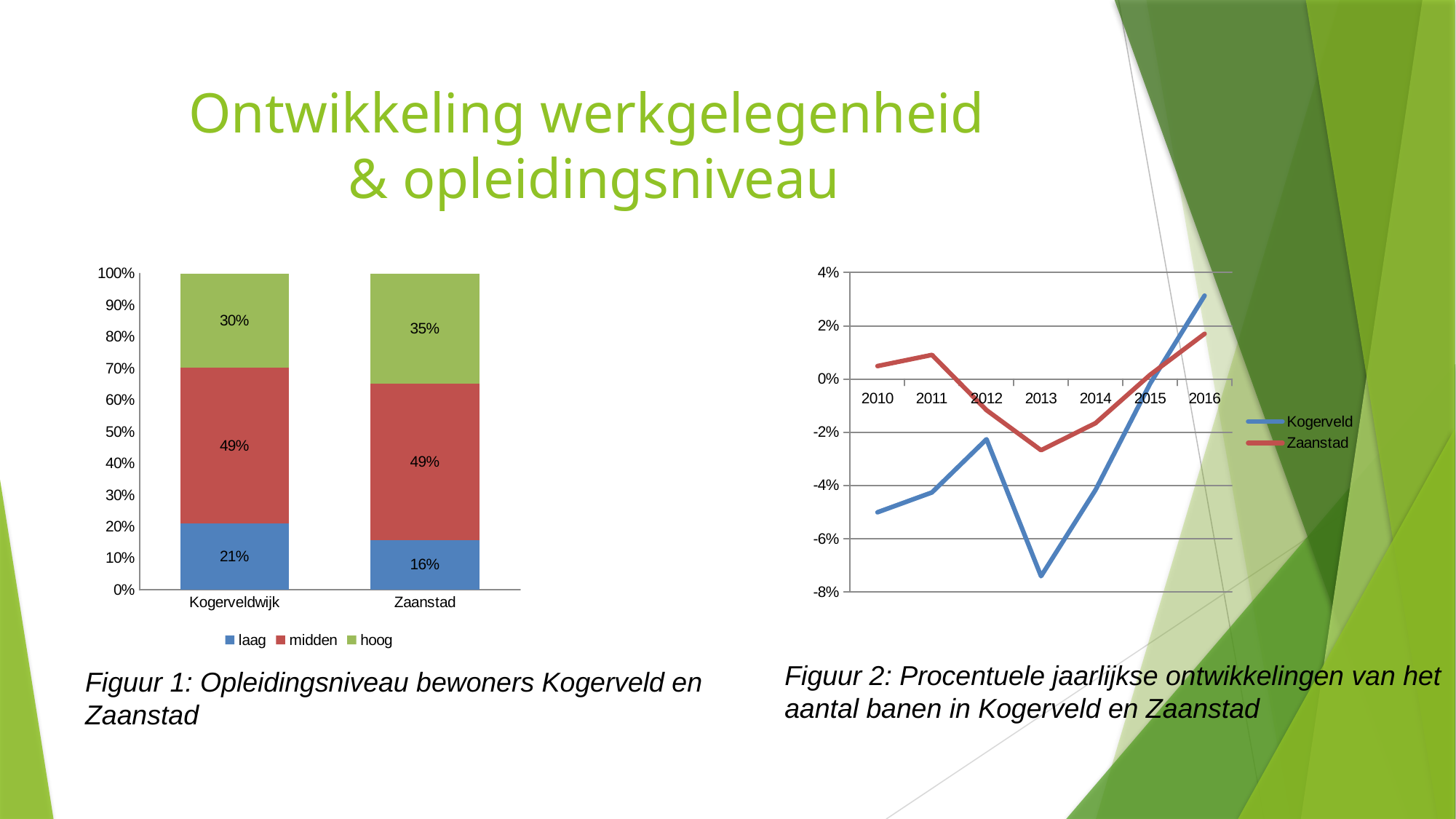
In Figuur 1, how many series does the legend list? 3 What kind of chart is Figuur 1? Stacked bar chart In Figuur 2, which series has the higher value in 2010, Kogerveld or Zaanstad? Zaanstad In Figuur 2, is the value for Kogerveld in 2013 greater or less than -6%? less In Figuur 1, what is the 'midden' share for Kogerveldwijk? 49% In Figuur 1, what is the difference between the 'hoog' share of Zaanstad and that of Kogerveldwijk? 5% In Figuur 1, what is the 'hoog' share for Zaanstad? 35% In Figuur 2, how many years are shown on the x axis? 7 In Figuur 2, in which year does the Kogerveld line reach its lowest value? 2013 In Figuur 2, in which year does the Kogerveld line reach its highest value? 2016 In Figuur 1, which has the larger 'laag' share, Kogerveldwijk or Zaanstad? Kogerveldwijk In Figuur 1, what percentage of Kogerveldwijk residents have a 'laag' education level? 21%